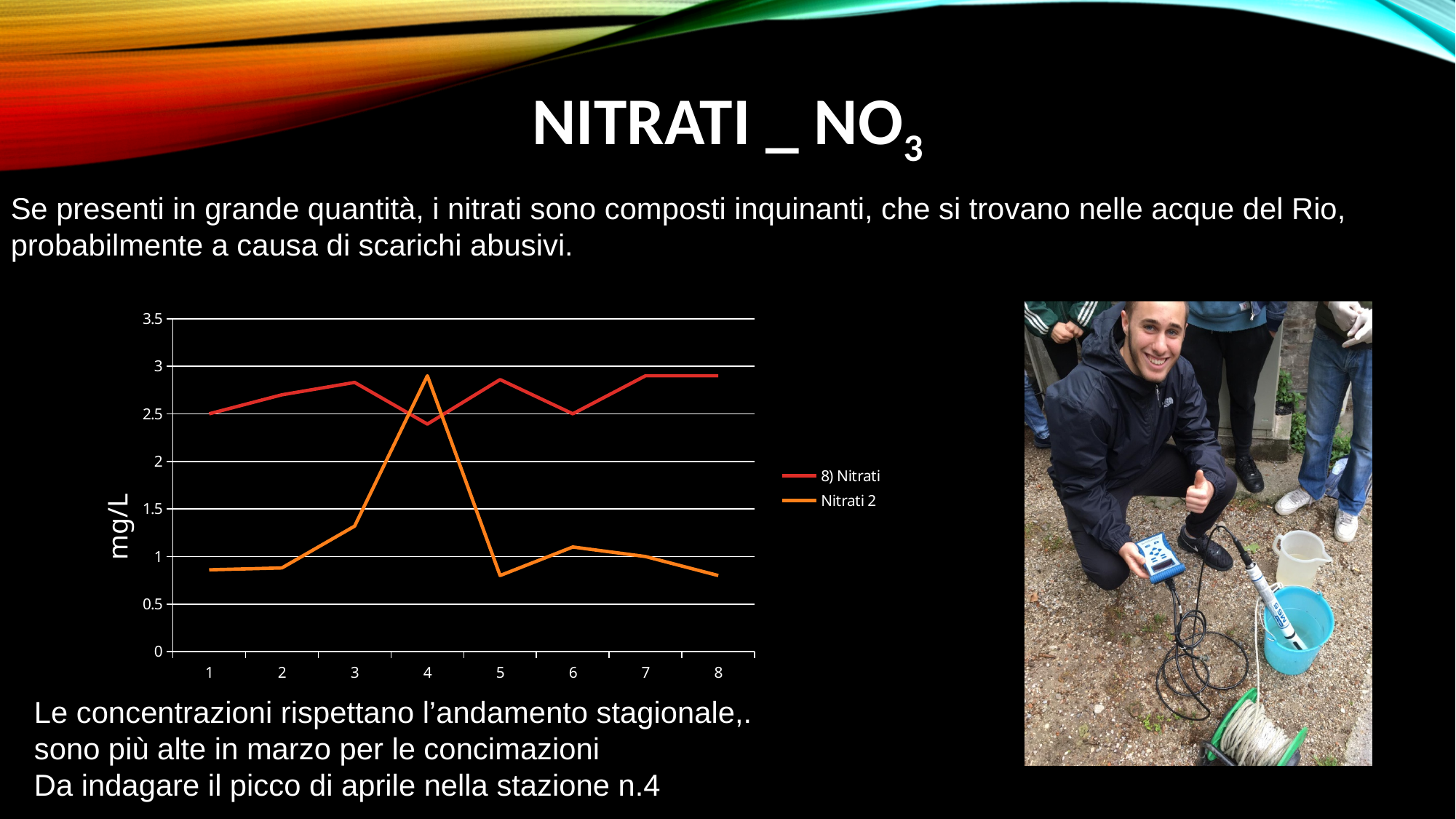
Is the value of Nitrati 2 at point 1 greater or less than 1? less What is the label on the y axis of the chart? mg/L At point 1, which series has the higher value, 8) Nitrati or Nitrati 2? 8) Nitrati Does the Nitrati 2 series rise or fall between point 4 and point 5? fall At point 4, which series has the higher value, 8) Nitrati or Nitrati 2? Nitrati 2 What kind of chart is shown on the slide? line chart How many points are plotted along the x axis for each series? 8 At which x-axis point does the Nitrati 2 series reach its highest value? 4 Is the value of 8) Nitrati at point 3 greater or less than 2.5? greater Is the value of Nitrati 2 at point 3 greater or less than 1? greater How many series does the chart legend list? 2